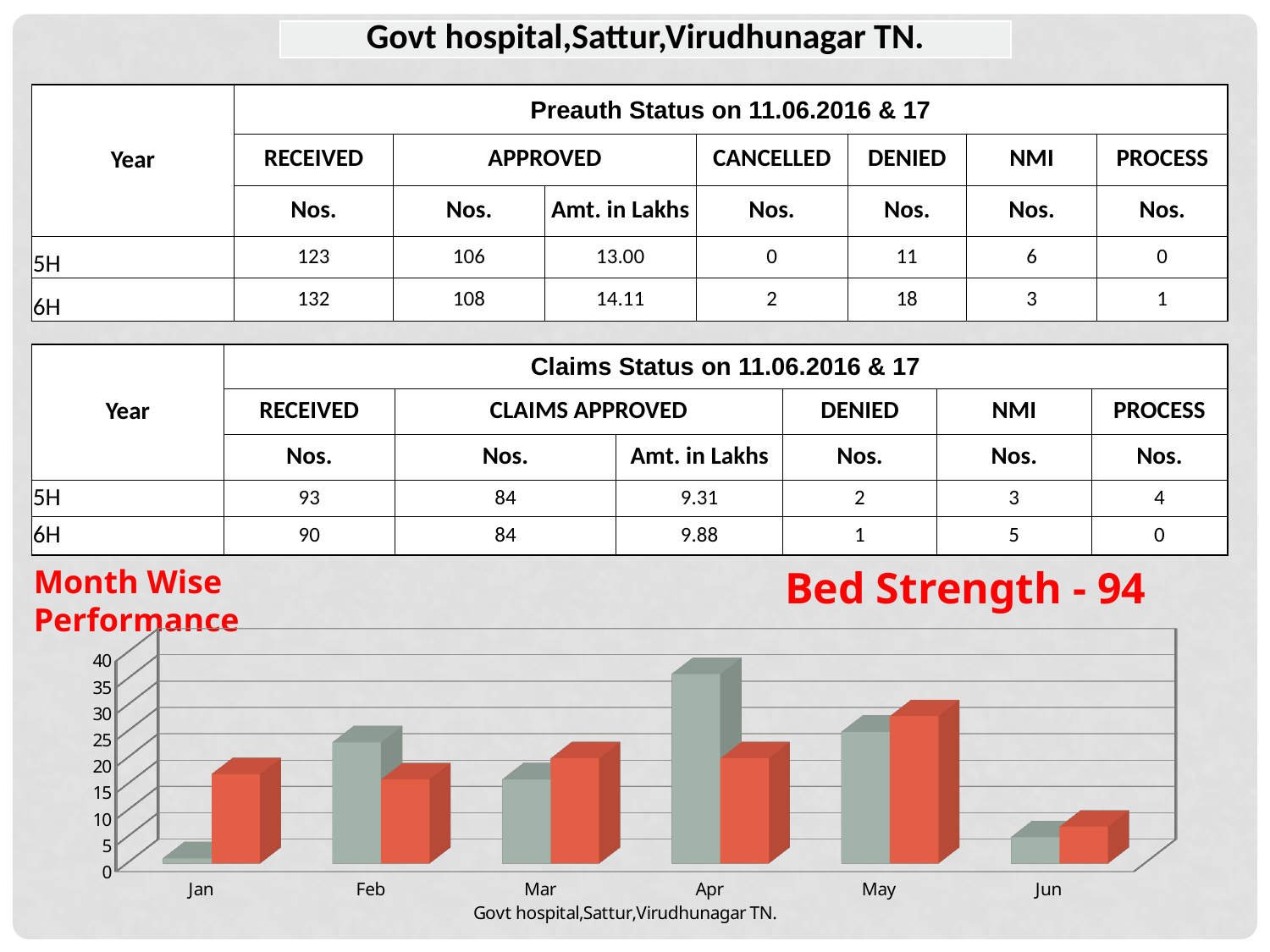
In the bar chart, which month has the tallest red bar? May In the bar chart, which month has the shortest red bar? Jun Is the value of the grey bar for Apr greater or less than 30? greater What kind of chart is shown at the bottom of the slide? bar chart In the bar chart, which month has the tallest grey bar? Apr In Jan, which bar is taller, the grey bar or the red bar? the red bar What is the title printed below the bar chart? Govt hospital,Sattur,Virudhunagar TN. Is the value of the red bar for Jun greater or less than 10? less How many months are shown on the x axis of the bar chart? 6 In the bar chart, which month has the shortest grey bar? Jan Is the value of the grey bar for Jan greater or less than 5? less In Feb, which bar is taller, the grey bar or the red bar? the grey bar